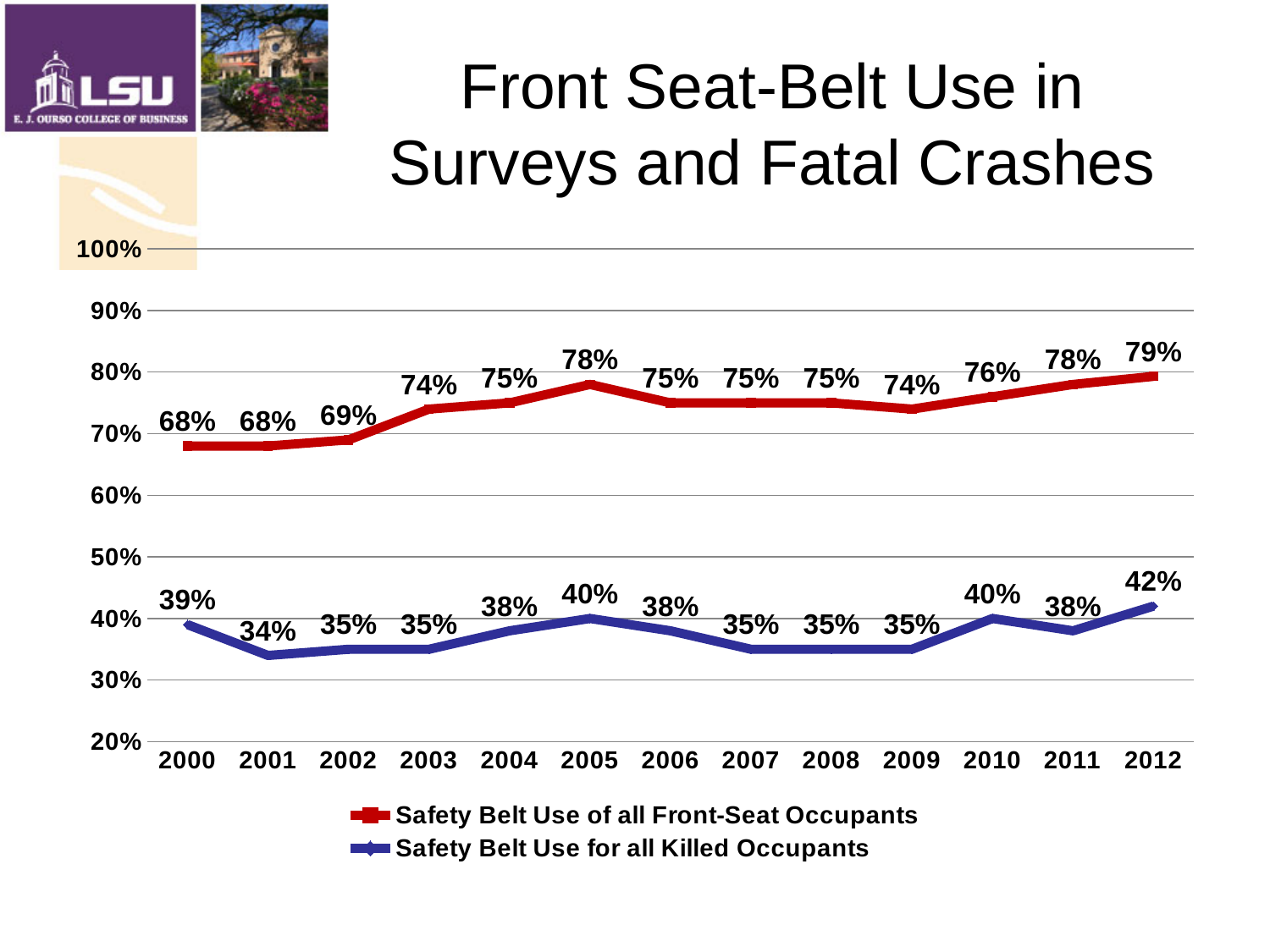
What is the difference between Safety Belt Use of all Front-Seat Occupants and Safety Belt Use for all Killed Occupants in 2012? 37% Which is larger in 2000: Safety Belt Use of all Front-Seat Occupants or Safety Belt Use for all Killed Occupants? Safety Belt Use of all Front-Seat Occupants What is the Safety Belt Use for all Killed Occupants value for 2001? 34% What kind of chart is shown on the slide? Line chart How many years are shown on the x axis? 13 What is the Safety Belt Use for all Killed Occupants value for 2012? 42% In which year is Safety Belt Use for all Killed Occupants lowest? 2001 How many series does the legend list? 2 Does Safety Belt Use of all Front-Seat Occupants rise or fall from 2000 to 2012 overall? Rise What is the Safety Belt Use of all Front-Seat Occupants value for 2005? 78% In which year is Safety Belt Use of all Front-Seat Occupants highest? 2012 What is the title of the chart? Front Seat-Belt Use in Surveys and Fatal Crashes